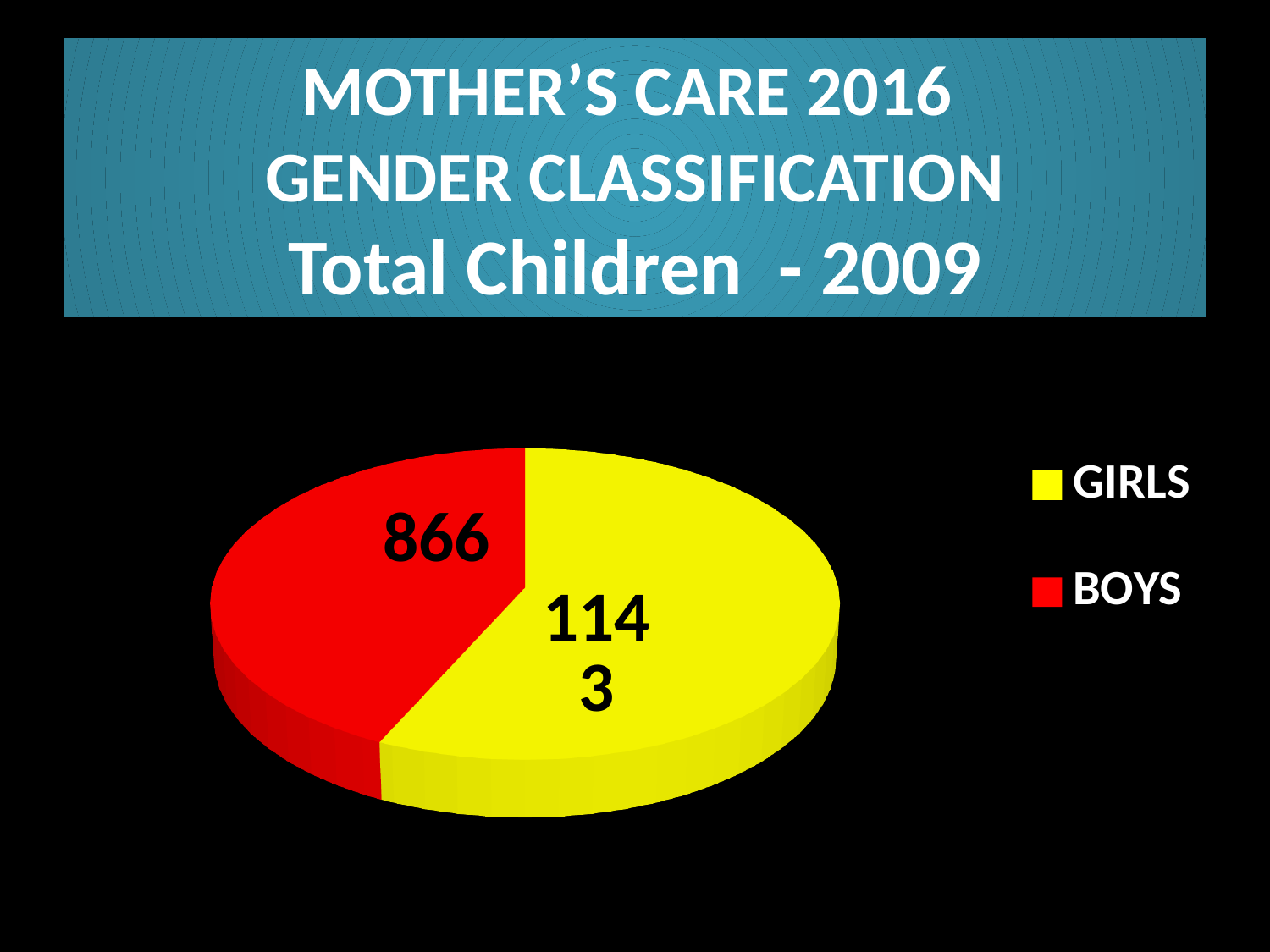
How many children are girls according to the pie chart? 1143 How many children are boys according to the pie chart? 866 What is the total number of children represented in the pie chart? 2009 How many entries does the legend list? 2 What is the difference between the number of girls and the number of boys? 277 Is the value for GIRLS larger or smaller than the value for BOYS? larger What colour is the GIRLS slice in the pie chart? yellow What kind of chart is shown on the slide? pie chart Which category has the smaller slice of the pie? BOYS Which category has the larger slice of the pie, GIRLS or BOYS? GIRLS How many categories does the pie chart have? 2 What colour is the BOYS slice in the pie chart? red